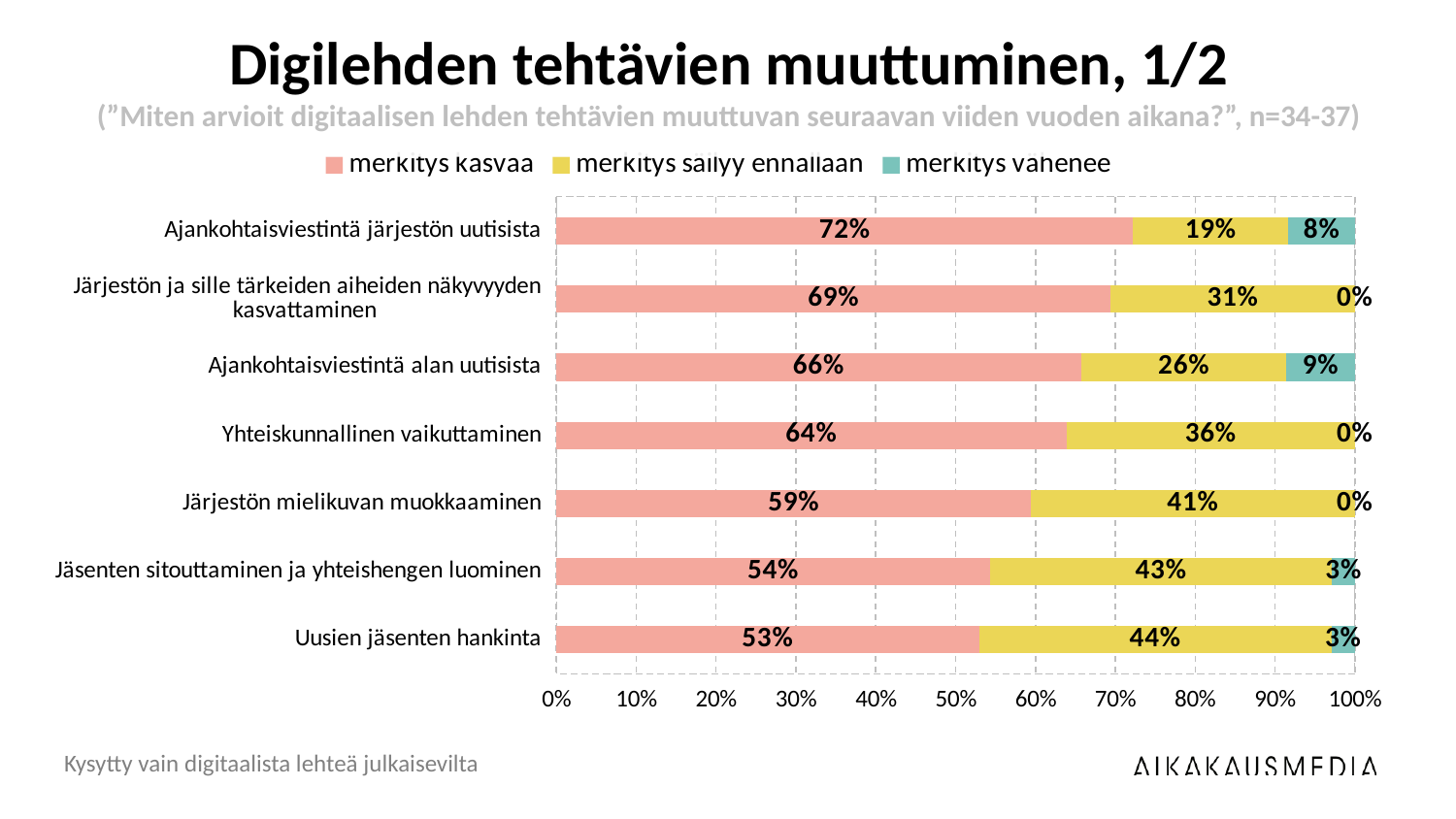
Which category has the lowest 'merkitys kasvaa' value? Uusien jäsenten hankinta Is the 'merkitys kasvaa' value for 'Jäsenten sitouttaminen ja yhteishengen luominen' greater or less than 50%? greater What kind of chart is shown on the slide? Stacked bar chart What is the 'merkitys säilyy ennallaan' value for 'Uusien jäsenten hankinta'? 44% How many categories are plotted on the chart? 7 Which is larger: the 'merkitys säilyy ennallaan' value for 'Järjestön mielikuvan muokkaaminen' or for 'Yhteiskunnallinen vaikuttaminen'? Järjestön mielikuvan muokkaaminen What is the difference between the 'merkitys kasvaa' values for 'Ajankohtaisviestintä järjestön uutisista' and 'Uusien jäsenten hankinta'? 19% How many series does the legend list? 3 Which category has the highest 'merkitys kasvaa' value? Ajankohtaisviestintä järjestön uutisista What is the 'merkitys vähenee' value for 'Ajankohtaisviestintä alan uutisista'? 9% What is the 'merkitys kasvaa' value for 'Ajankohtaisviestintä järjestön uutisista'? 72% What is the title of the chart on the slide? Digilehden tehtävien muuttuminen, 1/2